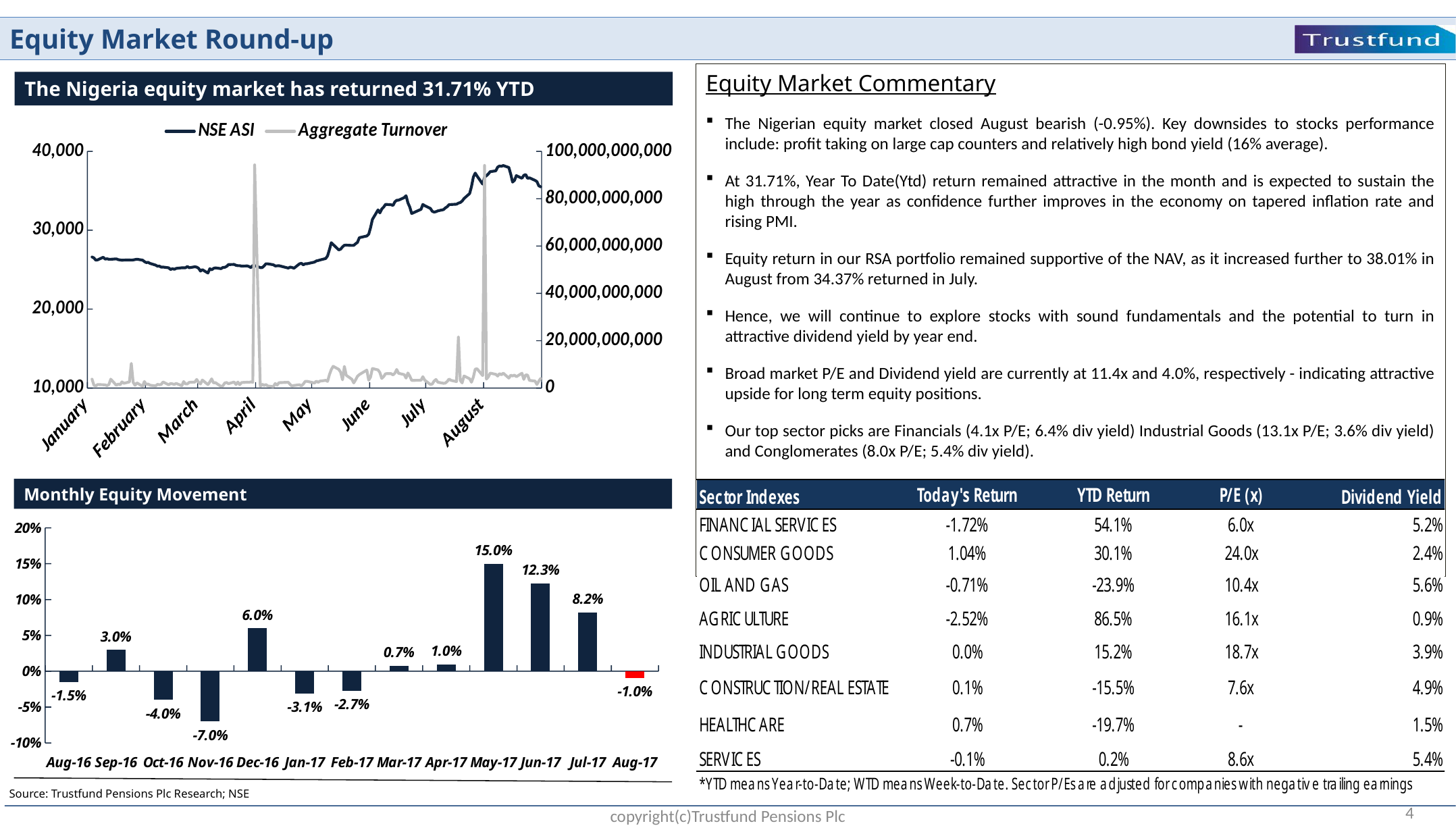
What kind of chart is the top-left chart showing NSE ASI and Aggregate Turnover? Line chart In the Monthly Equity Movement chart, which is larger, the value for Dec-16 or the value for Sep-16? Dec-16 What kind of chart is the Monthly Equity Movement chart? Bar chart In the Monthly Equity Movement chart, what is the value for May-17? 15.0% In the Monthly Equity Movement chart, what is the value for Aug-17? -1.0% In the Monthly Equity Movement chart, which month has the highest value? May-17 In the top-left chart, is the NSE ASI value in January greater or less than 30,000? less In the Monthly Equity Movement chart, what is the difference between the values for May-17 and Jun-17? 2.7% In the Monthly Equity Movement chart, which month has the lowest value? Nov-16 How many series does the legend of the top-left chart (The Nigeria equity market has returned 31.71% YTD) list? 2 How many months are shown in the Monthly Equity Movement chart? 13 In the Monthly Equity Movement chart, what is the value for Nov-16? -7.0%